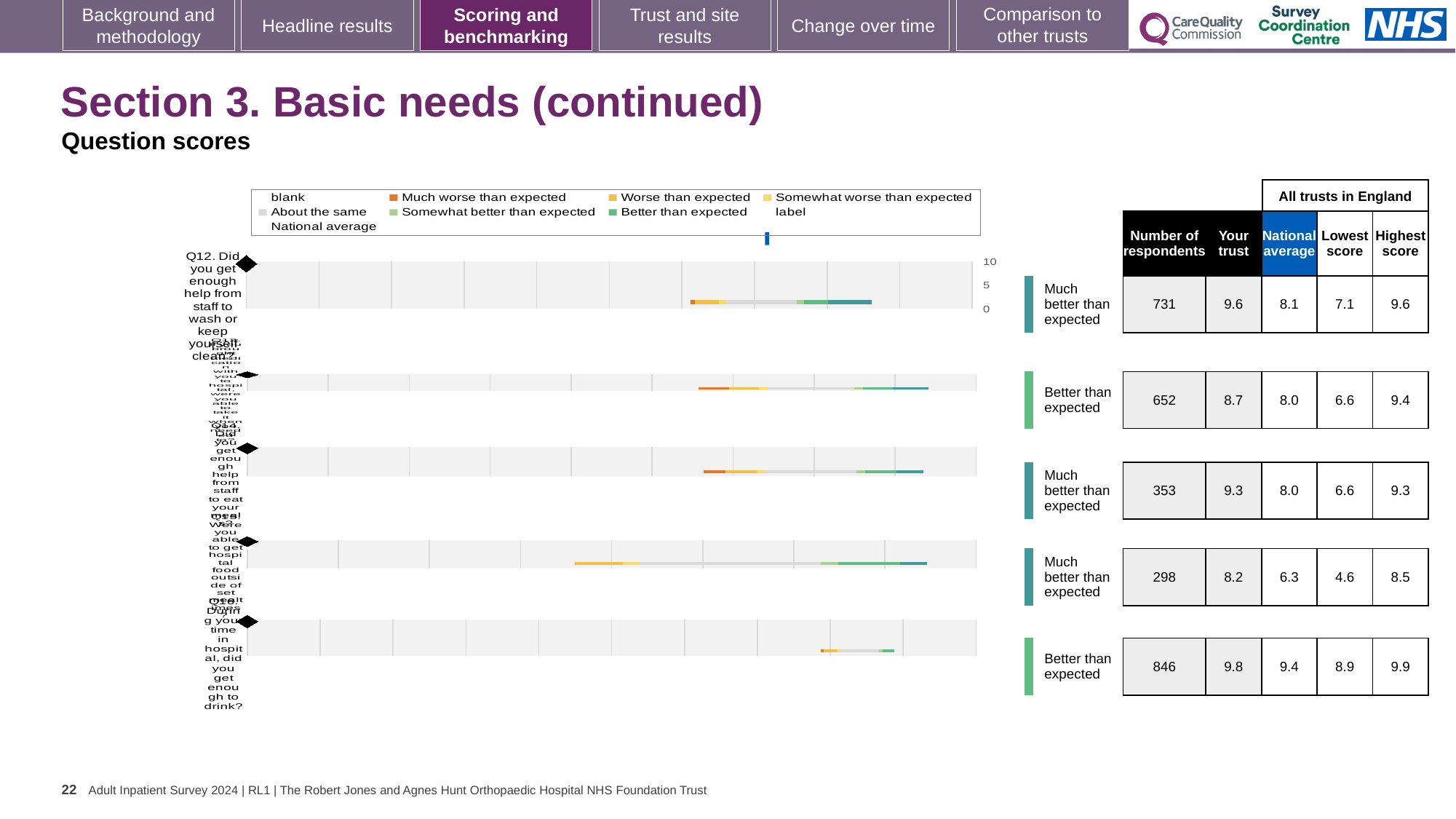
In the table beside the chart, what is the number of respondents for Q12 (the first row)? 731 In the chart legend, which entry is shown in dark teal green? Better than expected Which row in the table has the lowest national average? the fourth row (6.3) What type of chart is shown on the slide? bar chart In the table beside the chart, what is the 'Your trust' score for Q12 (the first row)? 9.6 What benchmark category is given for Q12 (the first row)? Much better than expected How many of the five questions are rated 'Much better than expected'? 3 In the chart legend, which colour represents 'Much worse than expected'? orange How many questions (bars) are plotted in the chart? 5 For Q12 (the first row), what is the difference between the 'Your trust' score and the national average? 1.5 In the table beside the chart, what is the national average for Q12 (the first row)? 8.1 Which row in the table has the highest number of respondents? the fifth row (846)